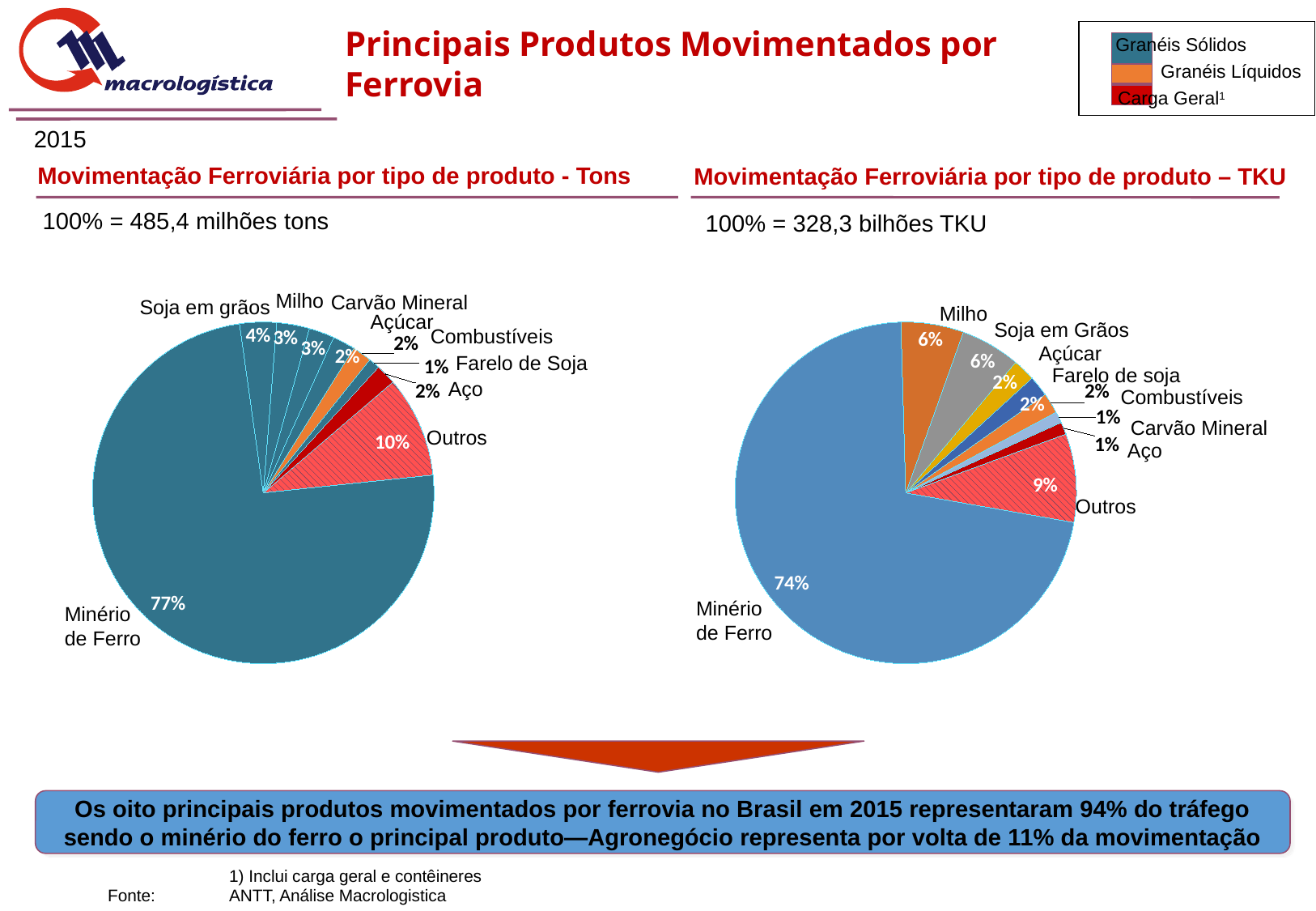
In the 'Movimentação Ferroviária por tipo de produto – TKU' chart, which product has the largest slice? Minério de Ferro In the 'Movimentação Ferroviária por tipo de produto - Tons' chart, what share does Minério de Ferro have? 77% In the 'Movimentação Ferroviária por tipo de produto – TKU' chart, what share does Milho have? 6% How many slices does the 'Movimentação Ferroviária por tipo de produto - Tons' pie chart have? 9 In the 'Movimentação Ferroviária por tipo de produto - Tons' chart, what share does Outros have? 10% What total does 100% represent in the 'Movimentação Ferroviária por tipo de produto – TKU' chart? 328,3 bilhões TKU What total does 100% represent in the 'Movimentação Ferroviária por tipo de produto - Tons' chart? 485,4 milhões tons In the 'Movimentação Ferroviária por tipo de produto - Tons' chart, what is the difference between the Minério de Ferro share and the Outros share? 67% In the 'Movimentação Ferroviária por tipo de produto – TKU' chart, what share does Minério de Ferro have? 74% What type of chart is used for 'Movimentação Ferroviária por tipo de produto – TKU'? Pie chart In the 'Movimentação Ferroviária por tipo de produto – TKU' chart, which is larger, the share for Milho or the share for Açúcar? Milho In the 'Movimentação Ferroviária por tipo de produto - Tons' chart, what share does Soja em grãos have? 4%